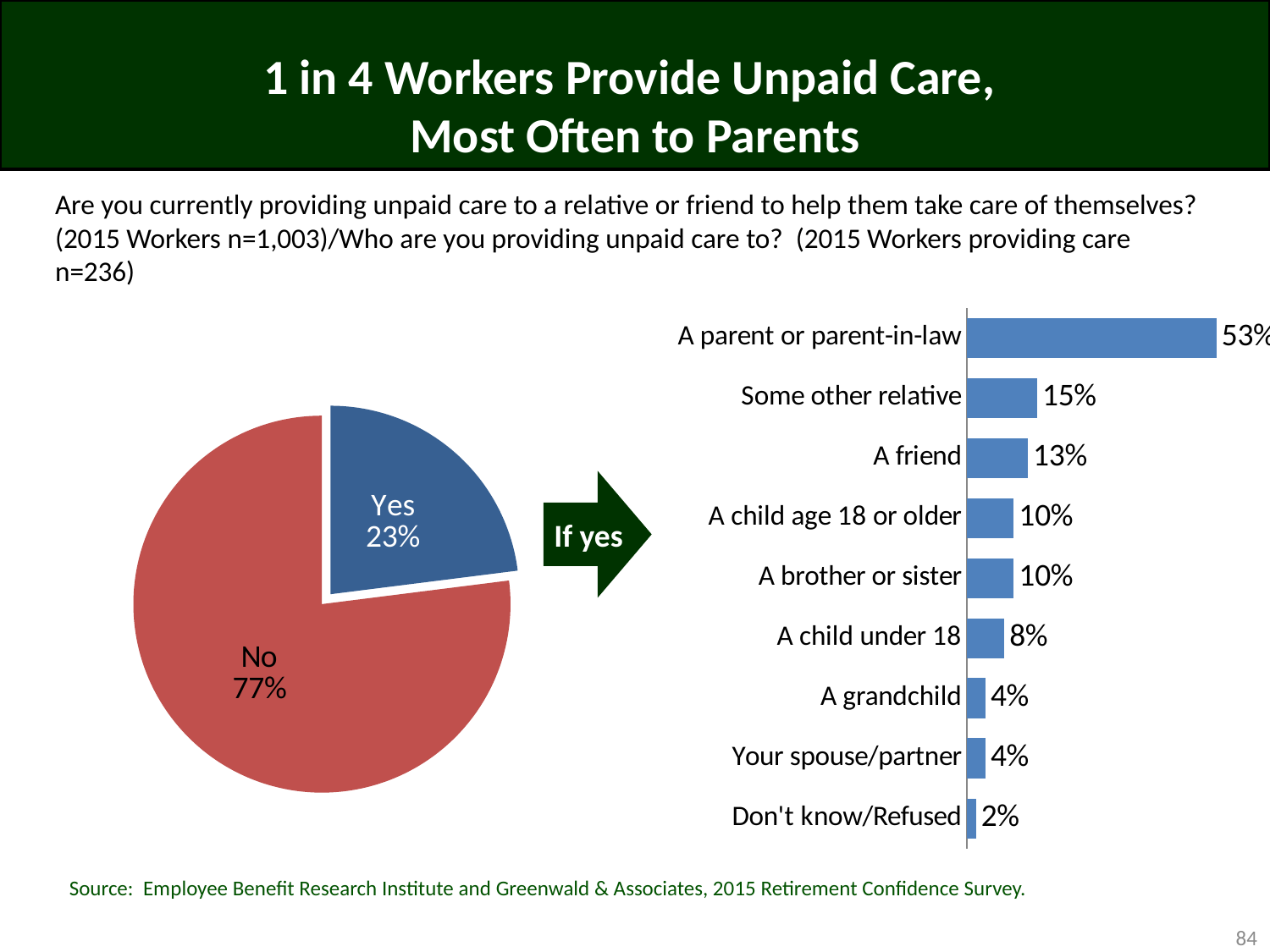
In the pie chart on the left, what share of workers answered No? 77% In the bar chart on the right, what is the value for 'A friend'? 13% In the pie chart on the left, what share of workers answered Yes? 23% What kind of chart is the chart on the left of the slide? pie chart In the bar chart on the right, which category has the lowest value? Don't know/Refused How many categories are shown in the bar chart on the right? 9 In the bar chart on the right, what is the difference between 'A parent or parent-in-law' and 'Some other relative'? 38% What kind of chart is the chart on the right of the slide? bar chart In the bar chart on the right, what is the value for 'Some other relative'? 15% In the bar chart on the right, which is larger: 'A child under 18' or 'A grandchild'? A child under 18 In the pie chart on the left, what colour is the 'No' slice? red In the bar chart on the right, which category has the highest value? A parent or parent-in-law